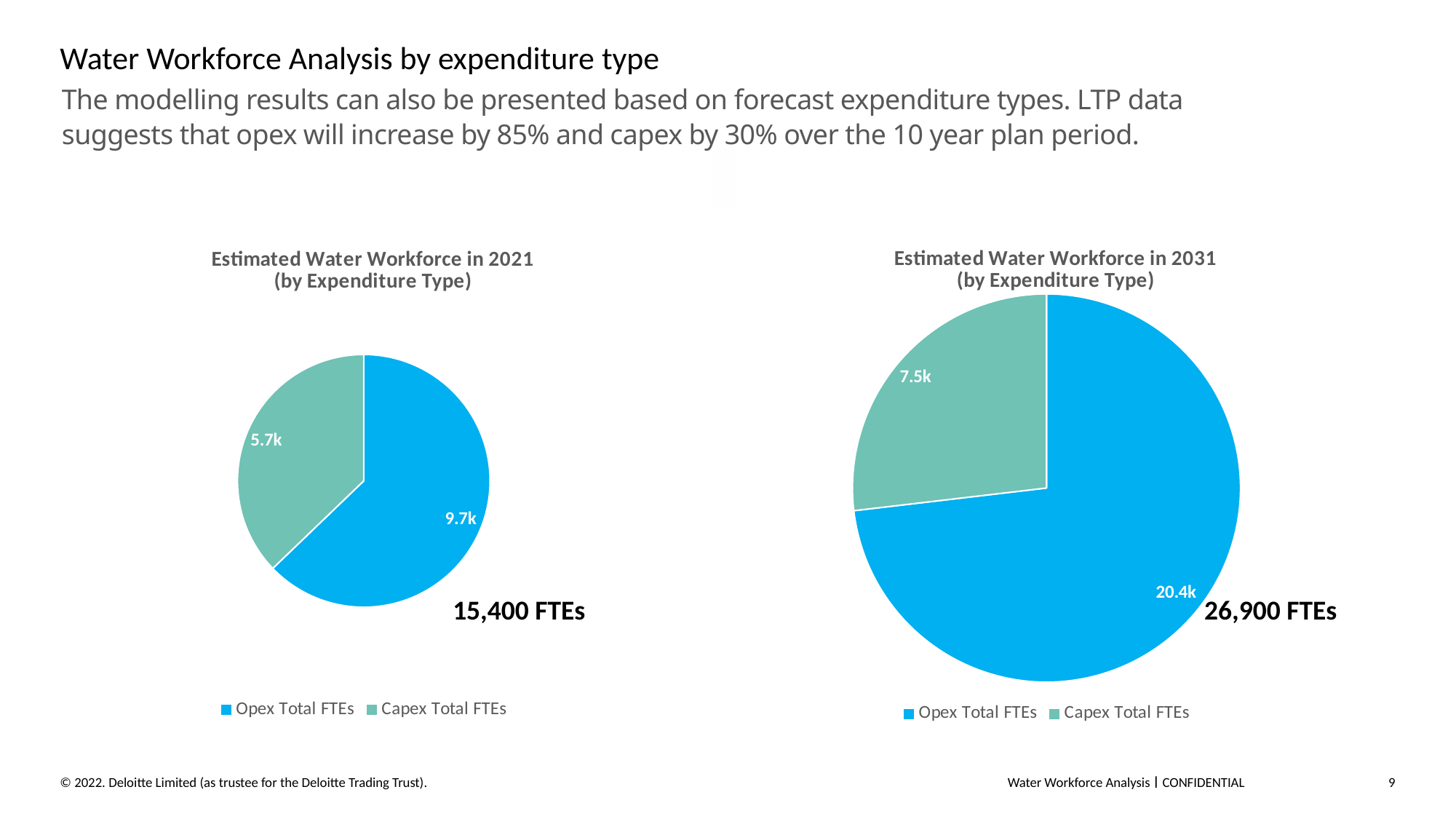
In the 'Estimated Water Workforce in 2031' pie chart, which slice is the largest? Opex Total FTEs What is the difference between the total FTEs shown for the 2031 chart and the 2021 chart? 11,500 FTEs In the 'Estimated Water Workforce in 2021' pie chart, what is the value for Capex Total FTEs? 5.7k What total number of FTEs is shown next to the 'Estimated Water Workforce in 2031' pie chart? 26,900 FTEs What total number of FTEs is shown next to the 'Estimated Water Workforce in 2021' pie chart? 15,400 FTEs In the 'Estimated Water Workforce in 2031' pie chart, which is larger: Opex Total FTEs or Capex Total FTEs? Opex Total FTEs How many slices does the 'Estimated Water Workforce in 2021' pie chart have? 2 In the 'Estimated Water Workforce in 2021' pie chart, what is the value for Opex Total FTEs? 9.7k In the 'Estimated Water Workforce in 2031' pie chart, what is the value for Capex Total FTEs? 7.5k What type of chart is 'Estimated Water Workforce in 2031 (by Expenditure Type)'? Pie chart In the 'Estimated Water Workforce in 2031' pie chart, what is the value for Opex Total FTEs? 20.4k In the 'Estimated Water Workforce in 2021' pie chart, which slice is the smallest? Capex Total FTEs